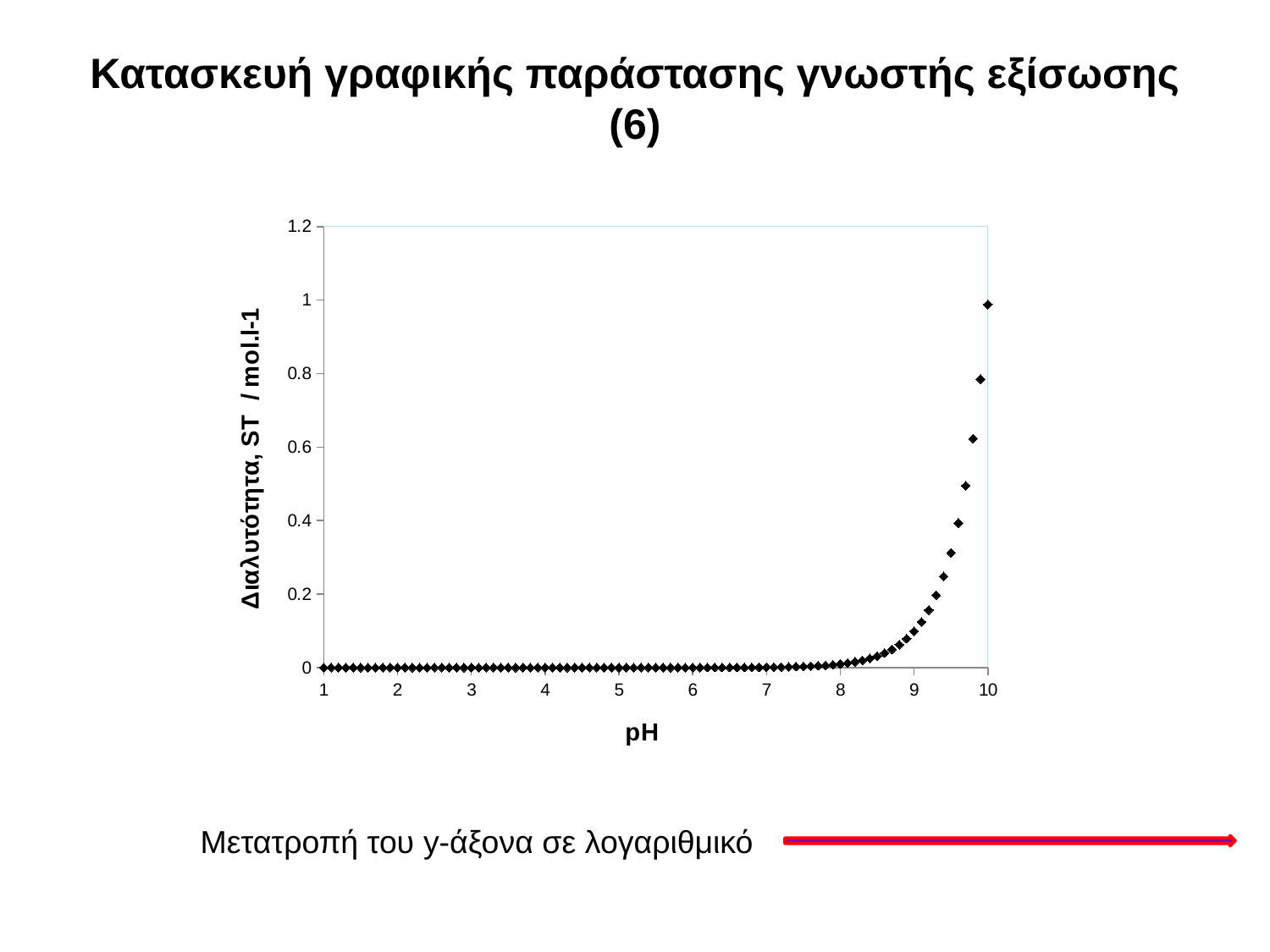
What kind of chart is shown on the slide? scatter chart What is the label of the x axis of the chart? pH Is the value plotted at pH 9 greater or less than 0.2? less Is the value plotted at pH 9.5 greater or less than 0.6? less Is the value plotted at pH 10 greater or less than 0.8? greater Do the plotted values rise or fall as pH increases from 8 to 10? rise Which has the smaller plotted value, pH 3 or pH 9.8? pH 3 What is the label of the y axis of the chart? Διαλυτότητα, ST / mol.l-1 Which has the larger plotted value, pH 9 or pH 10? pH 10 At which pH value is the plotted solubility highest? 10